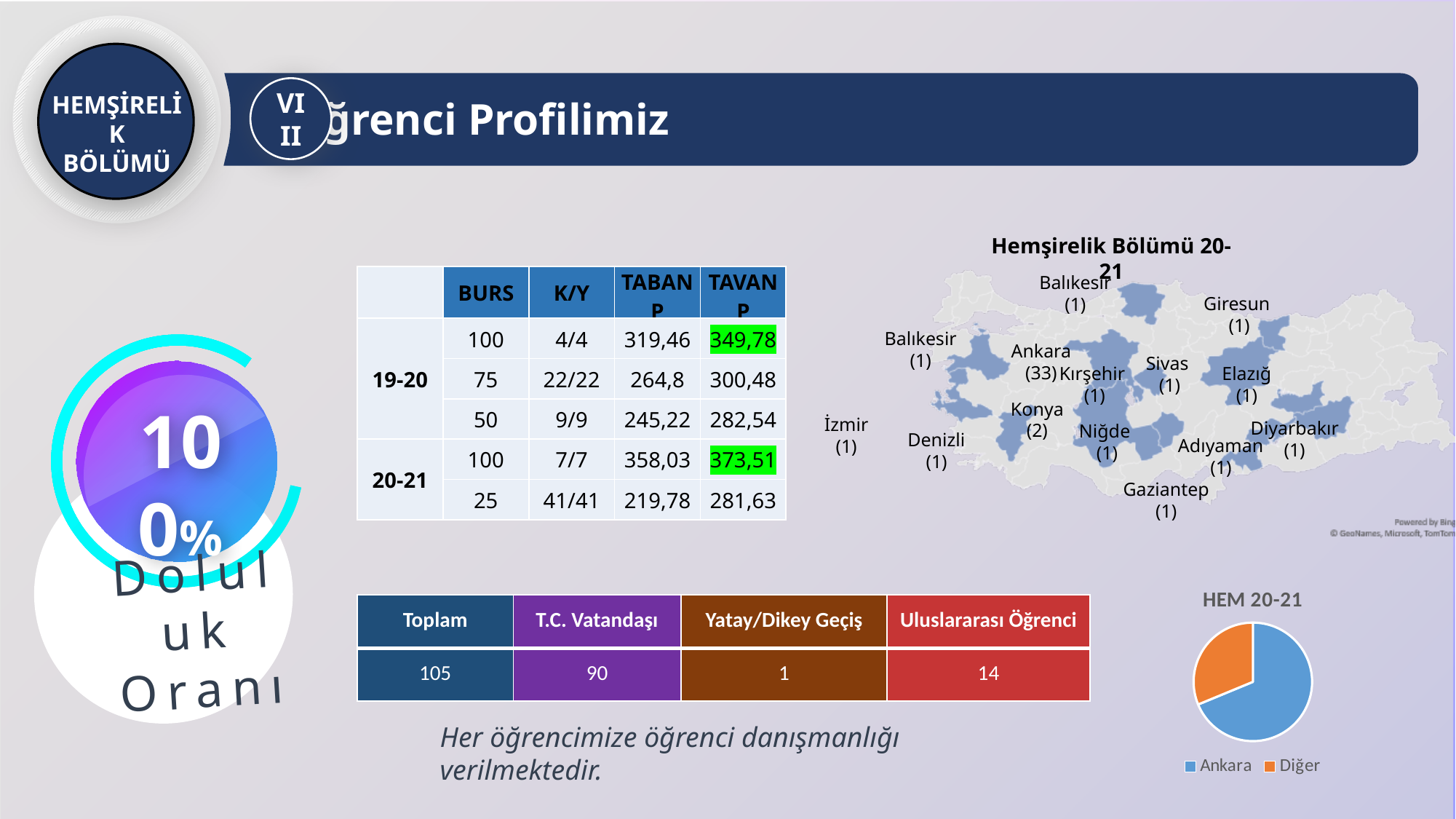
On the map chart titled "Hemşirelik Bölümü 20-21", what value is shown for Gaziantep? 1 In the "HEM 20-21" pie chart, what colour is the Ankara slice? blue On the map chart titled "Hemşirelik Bölümü 20-21", what value is shown for Ankara? 33 On the map chart titled "Hemşirelik Bölümü 20-21", what value is shown for Konya? 2 What are the two legend entries of the "HEM 20-21" pie chart? Ankara and Diğer What kind of chart is the chart titled "HEM 20-21" at the bottom right of the slide? pie chart On the map chart titled "Hemşirelik Bölümü 20-21", what is the difference between the values for Ankara and Konya? 31 What kind of chart is the chart titled "Hemşirelik Bölümü 20-21"? map chart On the map chart titled "Hemşirelik Bölümü 20-21", which city has the highest value? Ankara How many entries does the legend of the "HEM 20-21" pie chart list? 2 On the map chart titled "Hemşirelik Bölümü 20-21", which has the larger value, Ankara or Konya? Ankara In the "HEM 20-21" pie chart, which slice is larger, Ankara or Diğer? Ankara